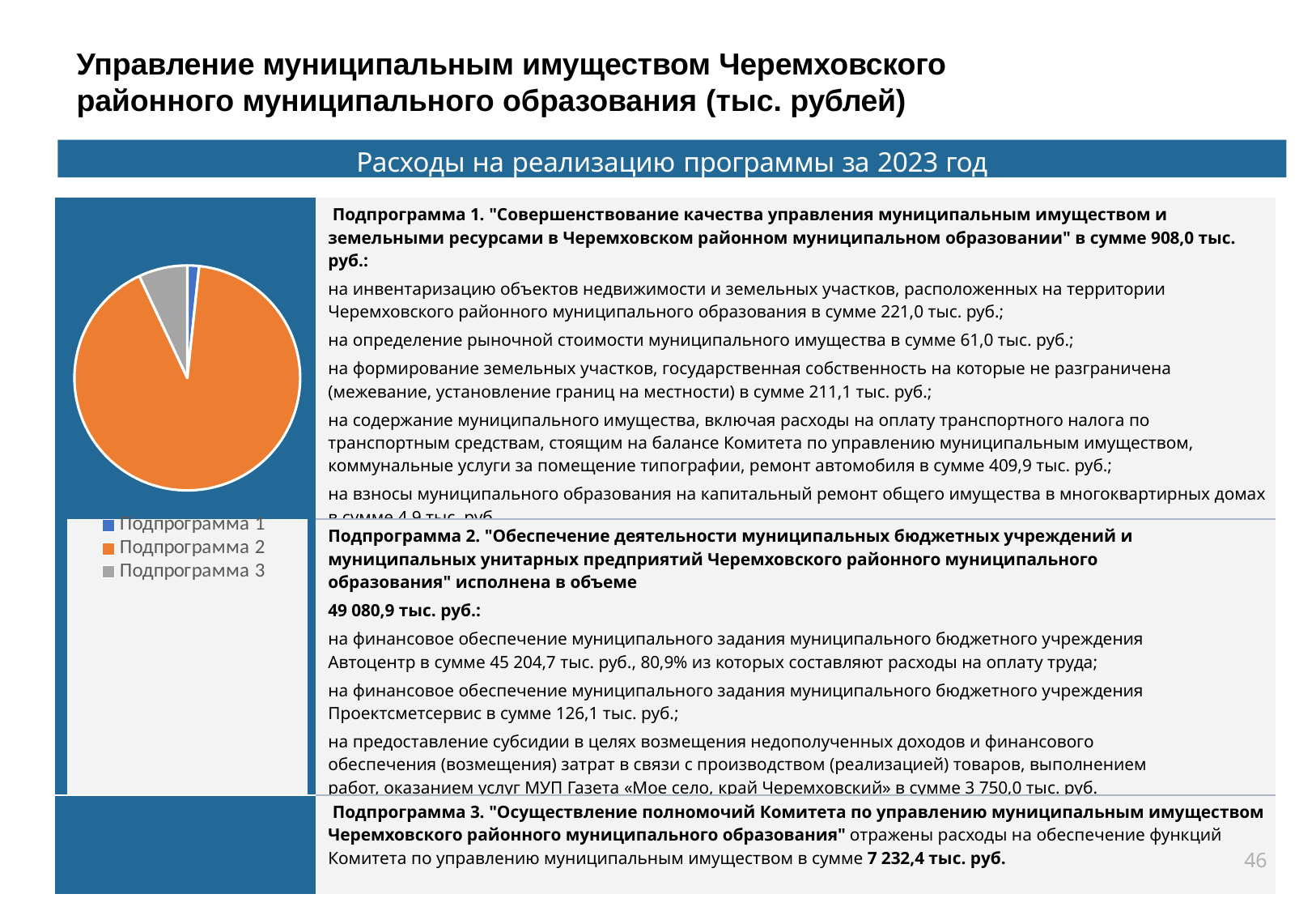
Which category has the largest slice in the pie chart? Подпрограмма 2 Which legend entry is shown in gray in the pie chart? Подпрограмма 3 How many entries does the legend of the pie chart list? 3 Which slice is larger in the pie chart, Подпрограмма 1 or Подпрограмма 3? Подпрограмма 3 What kind of chart is shown on the slide? pie chart What colour is the slice for Подпрограмма 2 in the pie chart? orange How many slices does the pie chart have? 3 Which slice is larger in the pie chart, Подпрограмма 2 or Подпрограмма 3? Подпрограмма 2 Which category has the smallest slice in the pie chart? Подпрограмма 1